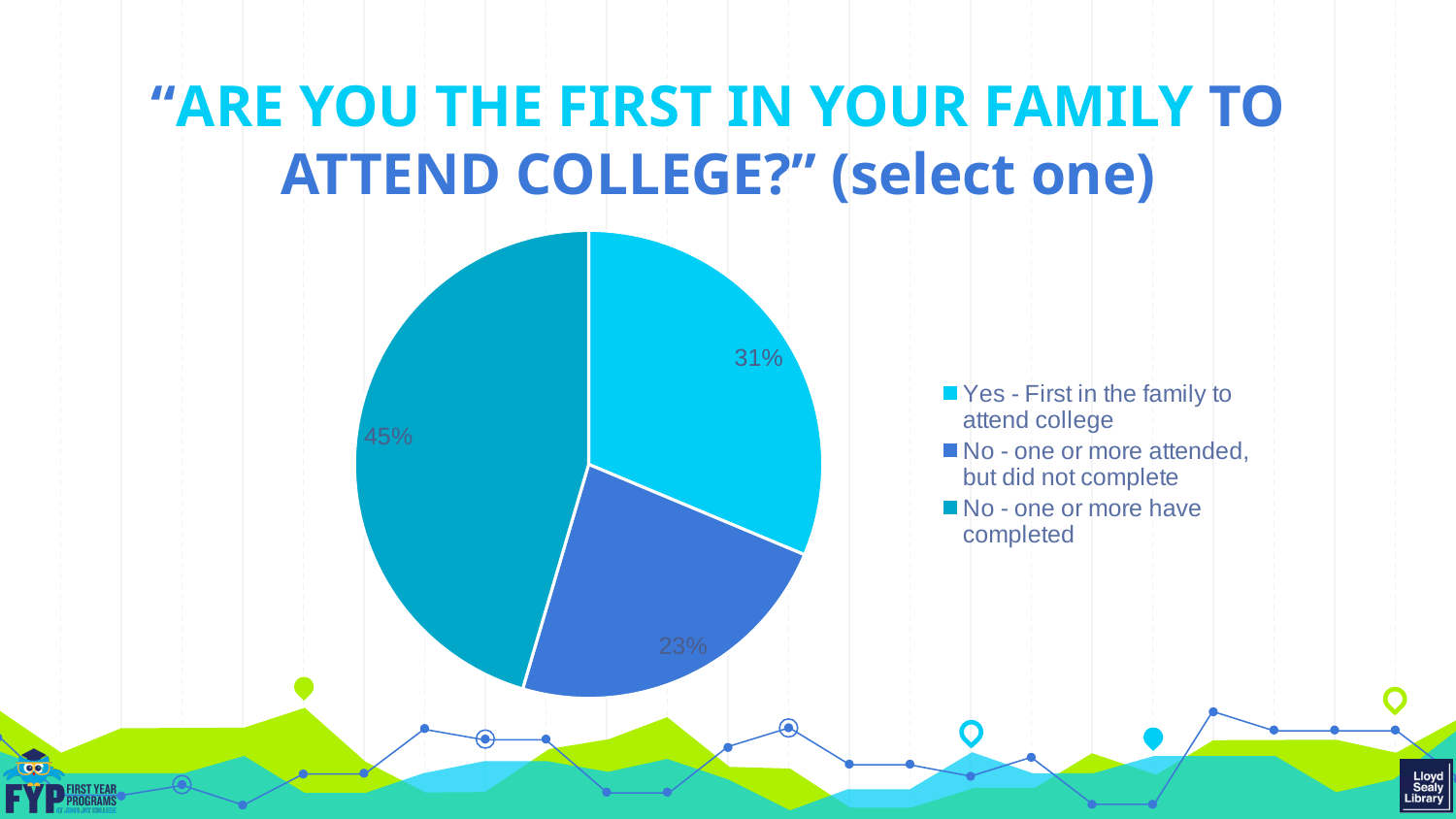
How many entries does the legend list? 3 What percentage of respondents answered "Yes - First in the family to attend college"? 31% What kind of chart is shown on the slide? pie chart What is the title of the chart on the slide? "ARE YOU THE FIRST IN YOUR FAMILY TO ATTEND COLLEGE?" (select one) Which response has the smallest share of the pie? No - one or more attended, but did not complete How many slices does the pie chart have? 3 Which is larger: the share for "Yes - First in the family to attend college" or the share for "No - one or more attended, but did not complete"? Yes - First in the family to attend college What is the combined percentage of the two "No" responses? 68% What percentage of respondents answered "No - one or more attended, but did not complete"? 23% What percentage of respondents answered "No - one or more have completed"? 45% Which response has the largest share of the pie? No - one or more have completed What is the difference in percentage points between "No - one or more have completed" and "Yes - First in the family to attend college"? 14